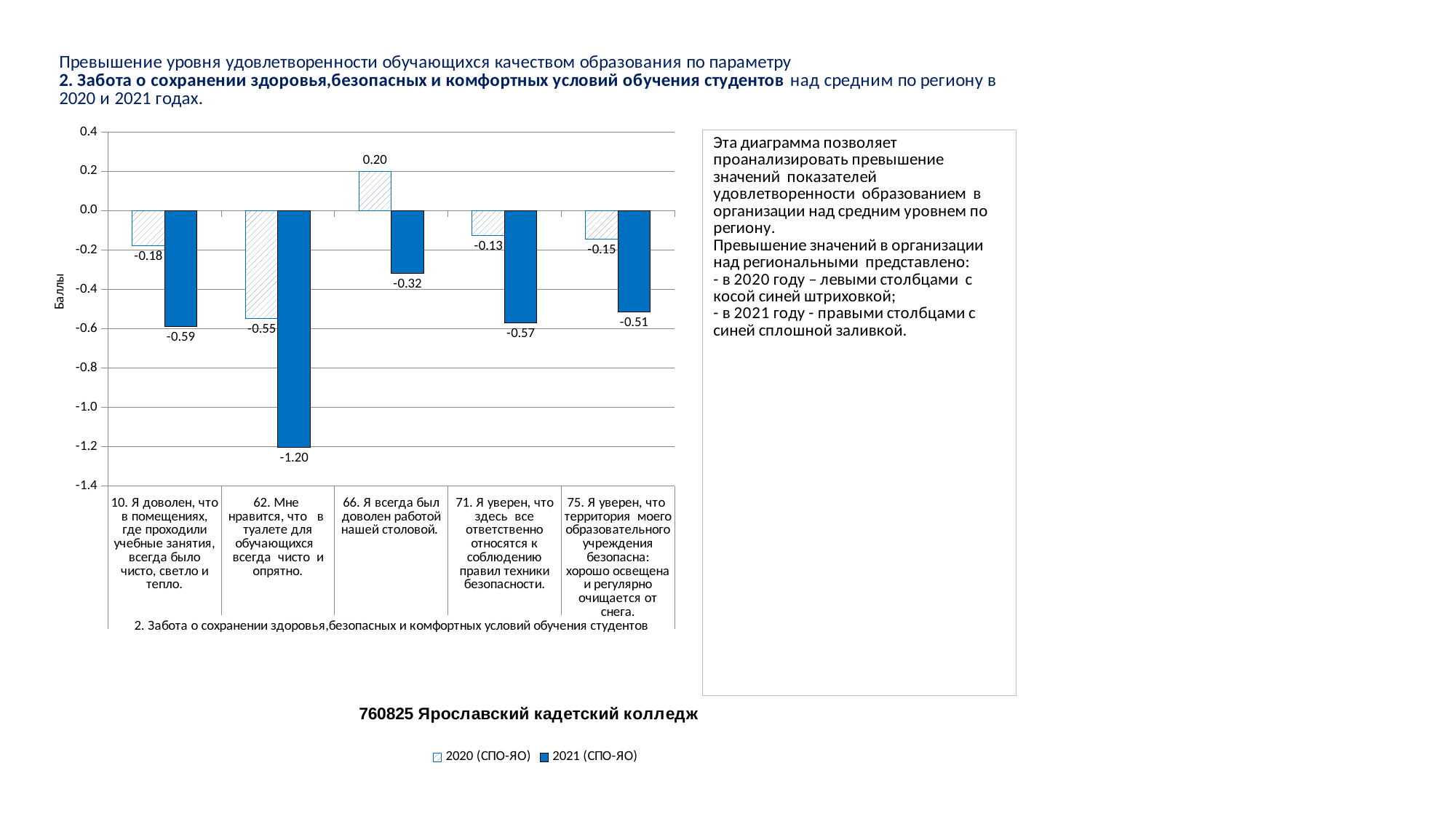
What is the difference between the 2020 and 2021 values for category 71 (Я уверен, что здесь все ответственно относятся к соблюдению правил техники безопасности)? 0.44 What is the 2021 (СПО-ЯО) value for category 62 (Мне нравится, что в туалете для обучающихся всегда чисто и опрятно)? -1.20 Which category has the lowest 2021 (СПО-ЯО) value? 62. Мне нравится, что в туалете для обучающихся всегда чисто и опрятно. How many series does the legend list? 2 What is the 2021 (СПО-ЯО) value for category 10 (Я доволен, что в помещениях, где проходили учебные занятия, всегда было чисто, светло и тепло)? -0.59 Is the 2021 (СПО-ЯО) value for category 62 greater or less than -1.0? less What type of chart is shown on the slide? bar chart How many categories (questions) are shown on the x axis of the chart? 5 Which series is shown with hatched (striped) bars in the chart? 2020 (СПО-ЯО) For category 75 (Я уверен, что территория моего образовательного учреждения безопасна), which is larger: the 2020 value or the 2021 value? 2020 (СПО-ЯО) What is the 2020 (СПО-ЯО) value for category 66 (Я всегда был доволен работой нашей столовой)? 0.20 Which category has the highest 2020 (СПО-ЯО) value? 66. Я всегда был доволен работой нашей столовой.